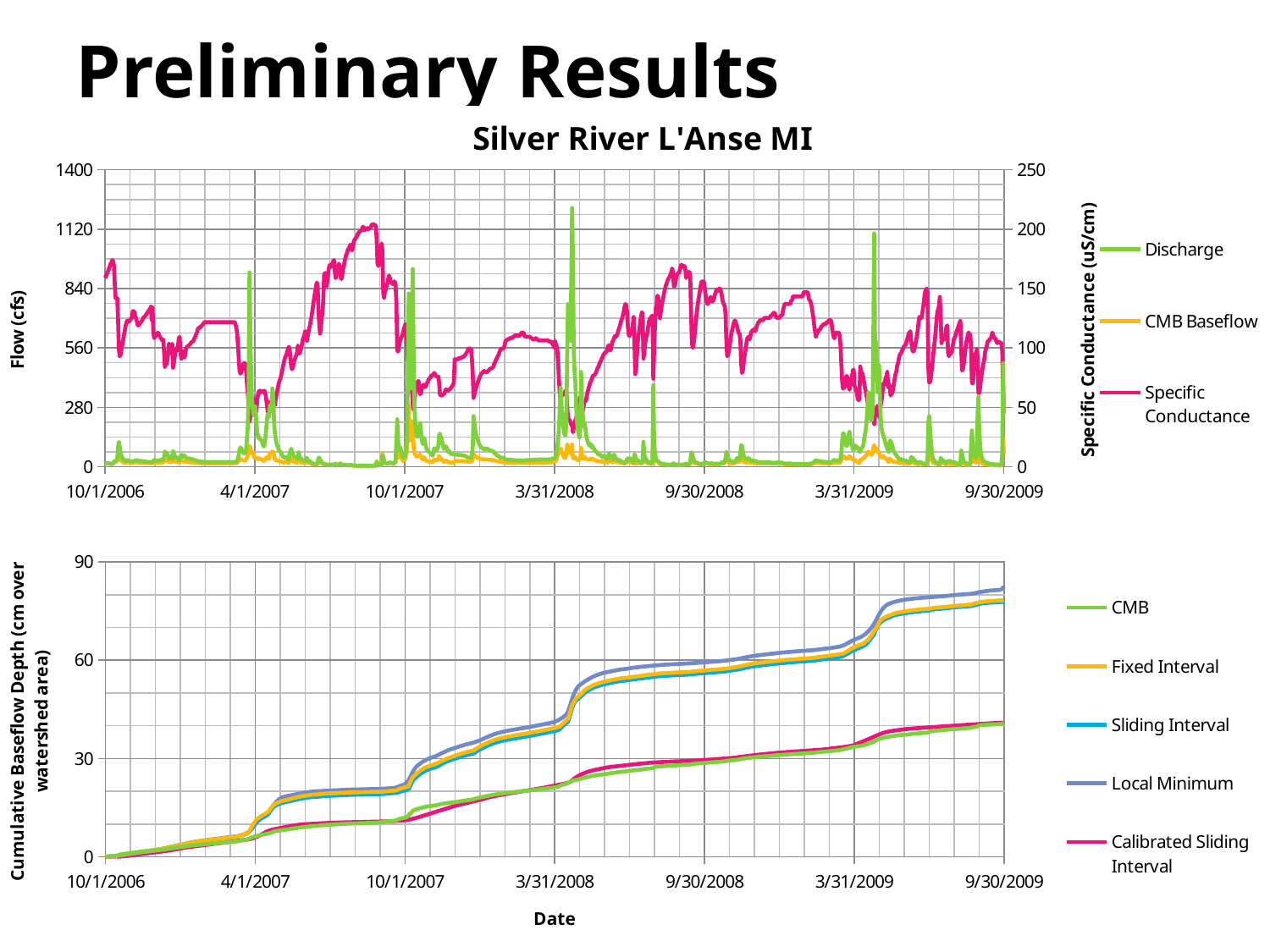
In the top chart, Silver River L'Anse MI, is the highest Discharge peak greater or less than 1120 cfs? greater What kind of chart is the top chart, Silver River L'Anse MI? line chart In the bottom chart (Cumulative Baseflow Depth), do the values rise or fall along the x axis? rise In the bottom chart (Cumulative Baseflow Depth), is the CMB value at 9/30/2009 greater or less than 60? less In the bottom chart (Cumulative Baseflow Depth), which is larger at 9/30/2009: Local Minimum or CMB? Local Minimum What is the title of the top chart? Silver River L'Anse MI In the top chart, Silver River L'Anse MI, what is the label of the left vertical axis? Flow (cfs) In the top chart, Silver River L'Anse MI, which is larger at 10/1/2006: Specific Conductance (right axis) or CMB Baseflow (left axis) relative to their axes? Specific Conductance How many series does the legend of the top chart, Silver River L'Anse MI, list? 3 How many series does the legend of the bottom chart (Cumulative Baseflow Depth) list? 5 In the bottom chart (Cumulative Baseflow Depth), is the Local Minimum value at 9/30/2009 greater or less than 60? greater In the bottom chart (Cumulative Baseflow Depth), which series has the highest value at 9/30/2009? Local Minimum